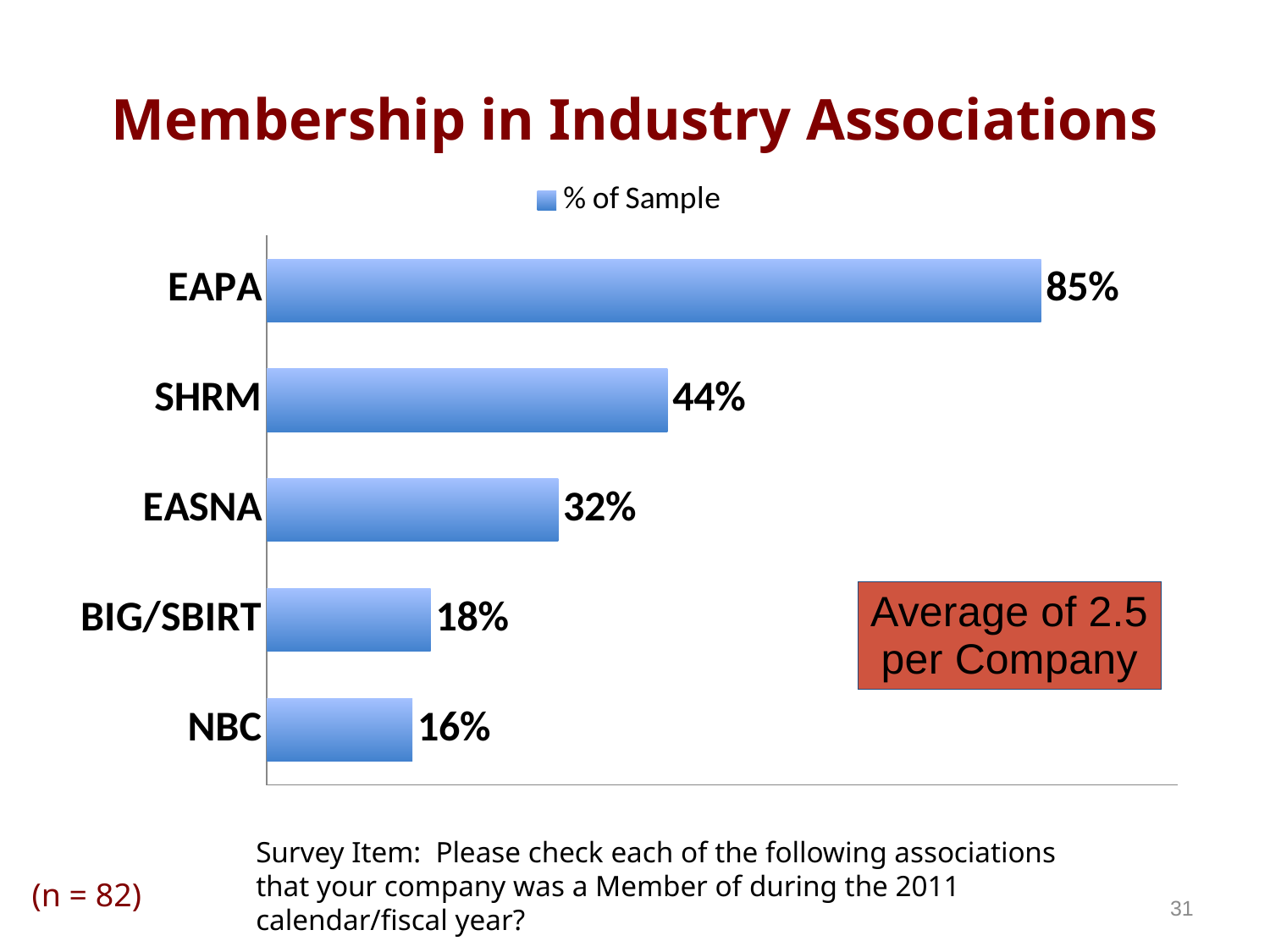
Which association has the lowest membership percentage? NBC Which association has the highest membership percentage? EAPA What is the value shown for SHRM? 44% What is the difference between the EASNA and NBC percentages? 16% How many associations are shown in the chart? 5 What percentage of the sample is a member of BIG/SBIRT? 18% What percentage of the sample is a member of EAPA? 85% What is the difference between the EAPA and SHRM percentages? 41% Which has a larger value, SHRM or EASNA? SHRM What is the legend entry for the series in the chart? % of Sample What kind of chart is shown on the slide? Bar chart How many series does the legend list? 1